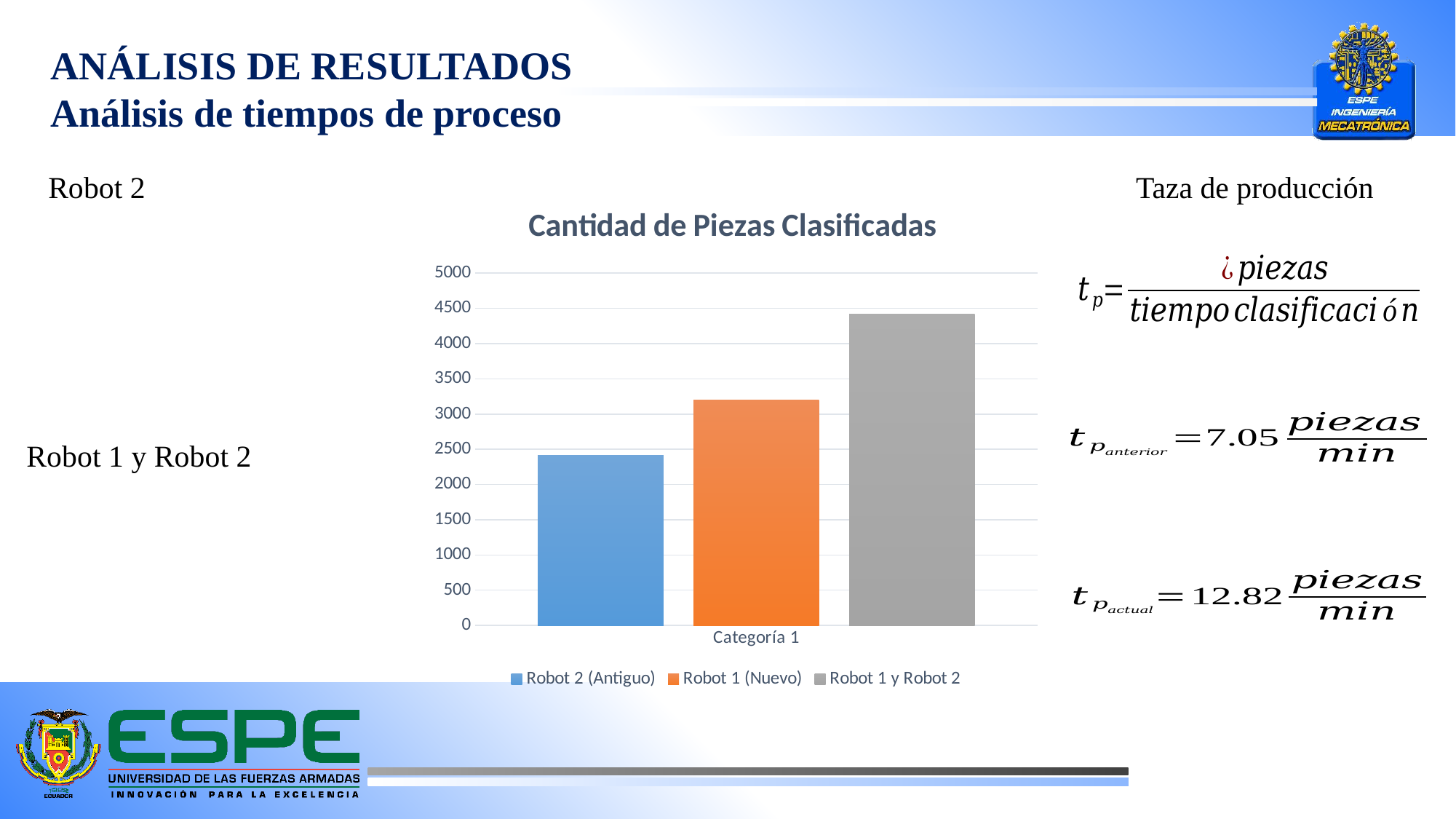
How many categories are shown on the x axis of the chart? 1 Which series has the lowest bar in the chart? Robot 2 (Antiguo) How many series does the chart legend list? 3 Which colour represents the Robot 1 (Nuevo) series in the chart? Orange Is the value for Robot 1 y Robot 2 greater or less than 4000? greater Is the value for Robot 2 (Antiguo) greater or less than 2000? greater Which is larger, the bar for Robot 1 (Nuevo) or the bar for Robot 2 (Antiguo)? Robot 1 (Nuevo) Is the value for Robot 2 (Antiguo) greater or less than 2500? less What type of chart is shown on the slide? Bar chart What is the title of the chart? Cantidad de Piezas Clasificadas Which series has the highest bar in the chart? Robot 1 y Robot 2